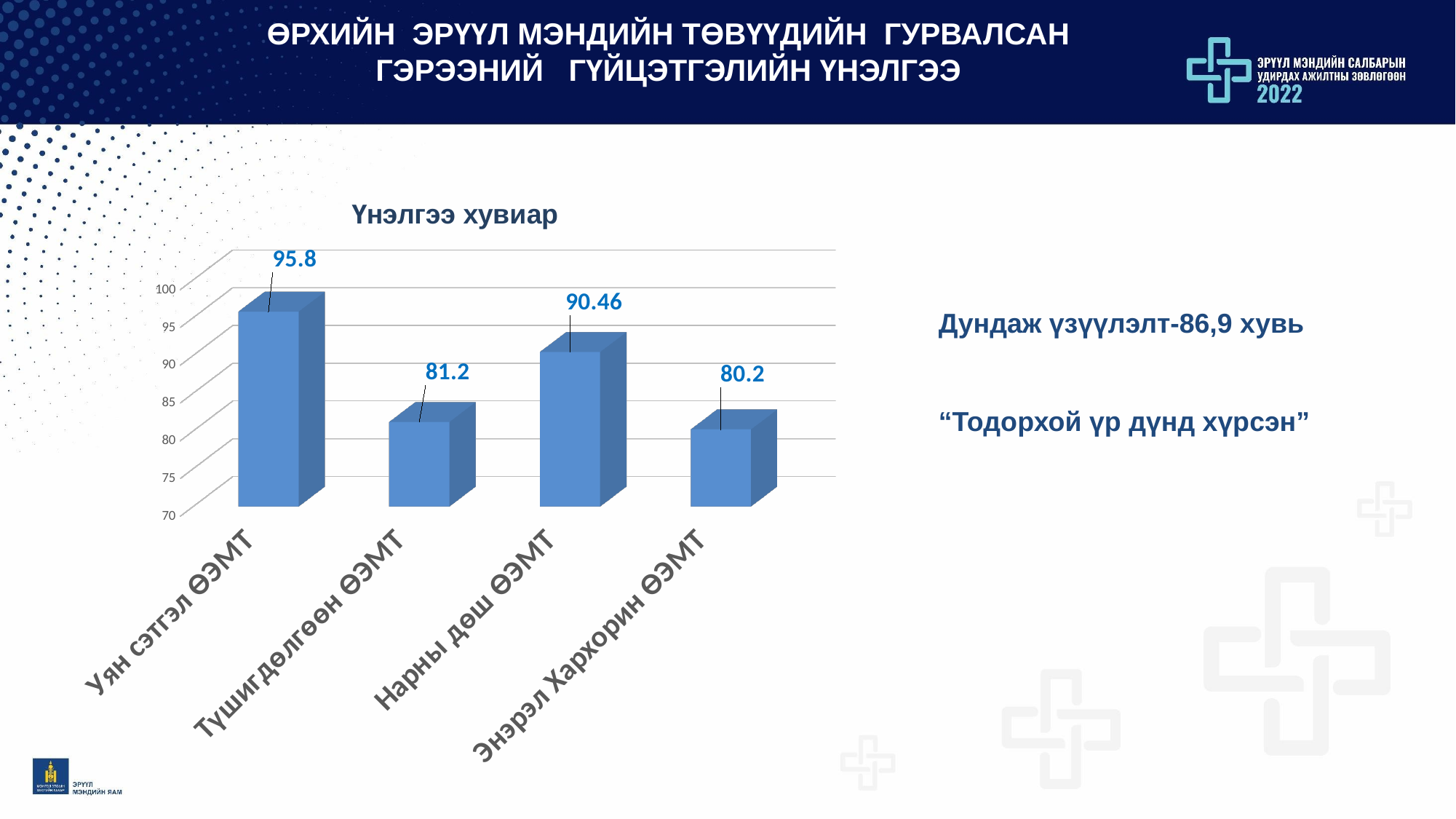
What is the value for Нарны дөш ӨЭМТ? 90.46 What is the value for Түшигдөлгөөн ӨЭМТ? 81.2 How many categories are shown in the chart? 4 What kind of chart is shown on the slide? bar chart Which category has the lowest value? Энэрэл Хархорин ӨЭМТ Which category has the highest value? Уян сэтгэл ӨЭМТ Is the value for Нарны дөш ӨЭМТ greater or less than 85? greater What is the difference between the values for Уян сэтгэл ӨЭМТ and Энэрэл Хархорин ӨЭМТ? 15.6 Which is larger, the value for Нарны дөш ӨЭМТ or the value for Түшигдөлгөөн ӨЭМТ? Нарны дөш ӨЭМТ What is the value for Энэрэл Хархорин ӨЭМТ? 80.2 What is the value for Уян сэтгэл ӨЭМТ? 95.8 What is the title of the chart? Үнэлгээ хувиар